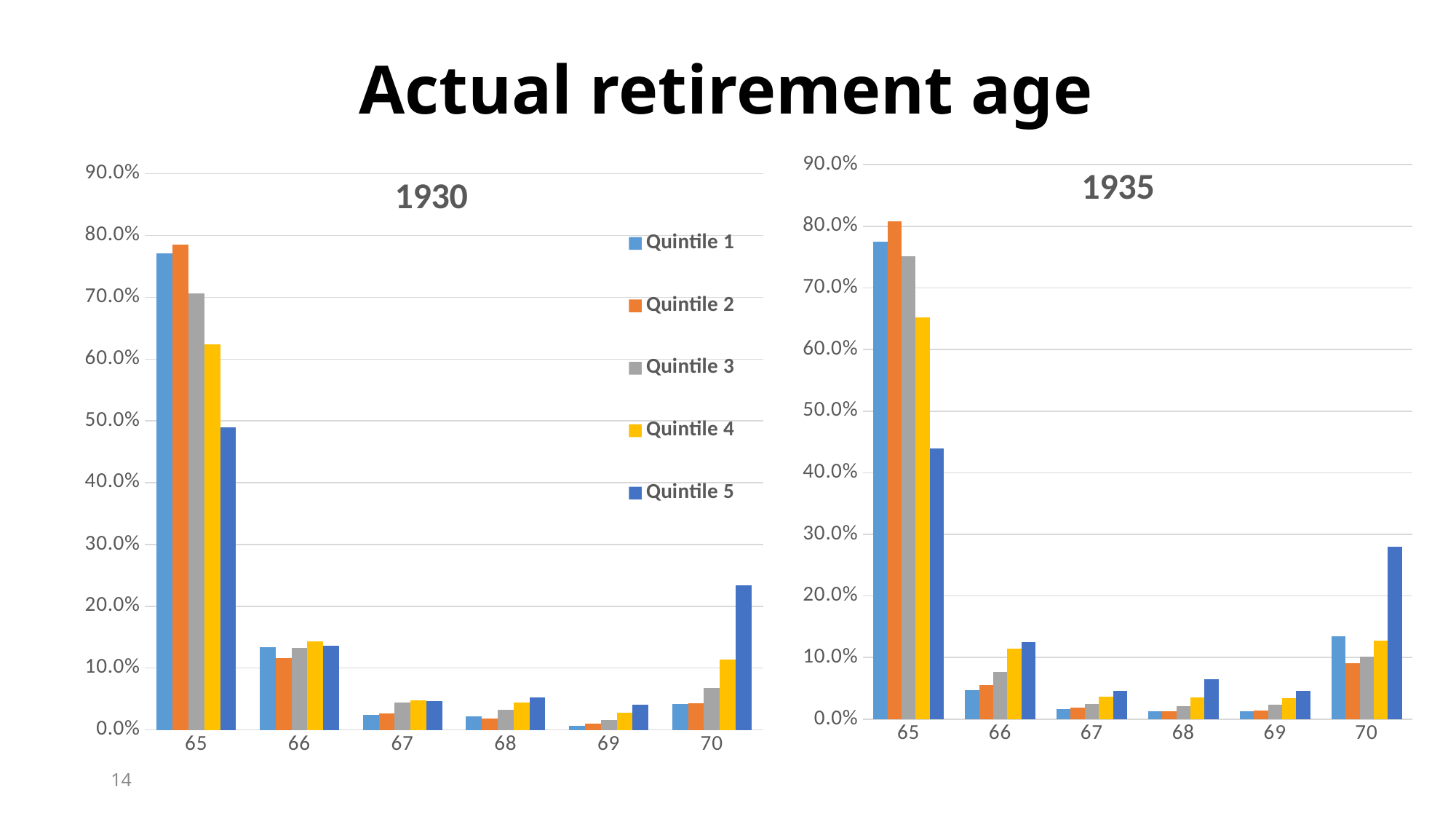
In the 1935 chart, which quintile has the lowest value at age 65? Quintile 5 What is the title of the chart on the right? 1935 In the 1930 chart, is the value for Quintile 5 at age 65 greater or less than 40.0%? greater What kind of chart is the 1930 chart? bar chart How many series does the legend list? 5 In the 1935 chart, which quintile has the highest value at age 65? Quintile 2 In the 1935 chart, does the value for Quintile 5 rise or fall from age 65 to age 66? fall In the 1935 chart, at age 65, which is larger: Quintile 3 or Quintile 4? Quintile 3 In the 1935 chart, is the value for Quintile 5 at age 70 greater or less than 20.0%? greater In the 1930 chart, which quintile has the lowest value at age 65? Quintile 5 In the 1930 chart, which quintile has the highest value at age 70? Quintile 5 How many age categories are shown on the x axis of the 1935 chart? 6